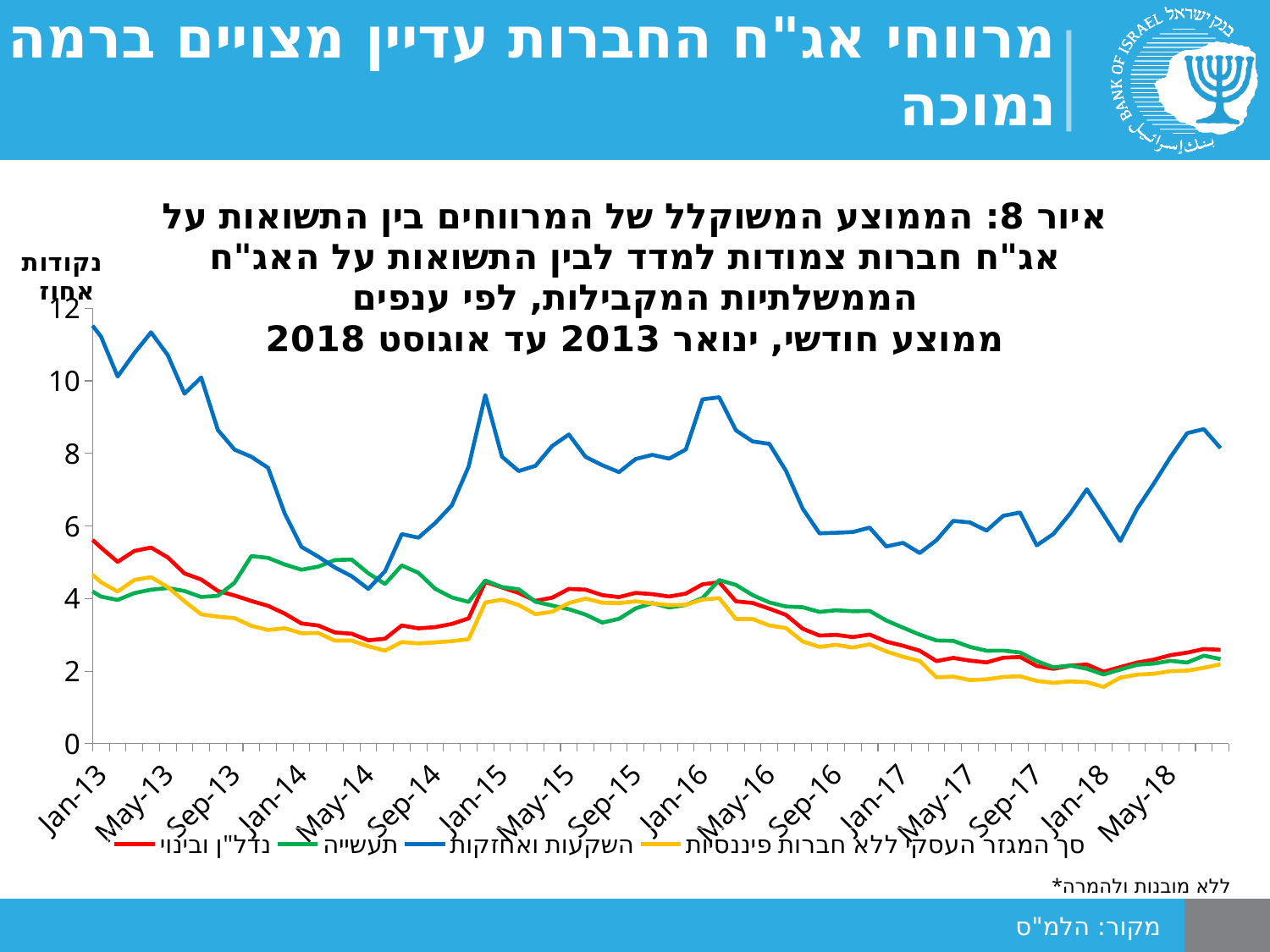
Which series has the lowest value at May-17? סך המגזר העסקי ללא חברות פיננסיות Which series is plotted with the blue line? השקעות ואחזקות How many series does the legend list? 4 What is the unit label shown at the top of the vertical axis? נקודות אחוז Is the value for נדל"ן ובינוי at Jan-13 greater or less than 6? less At Jan-14, which is larger: the value for תעשייה or the value for נדל"ן ובינוי? תעשייה Is the value for השקעות ואחזקות at Jan-13 greater or less than 10? greater What kind of chart is shown on the slide? line chart Is the value for סך המגזר העסקי ללא חברות פיננסיות at May-17 greater or less than 2? less Which series has the highest value at Jan-13? השקעות ואחזקות Does the value for השקעות ואחזקות rise or fall from Jan-13 to Jan-14? fall